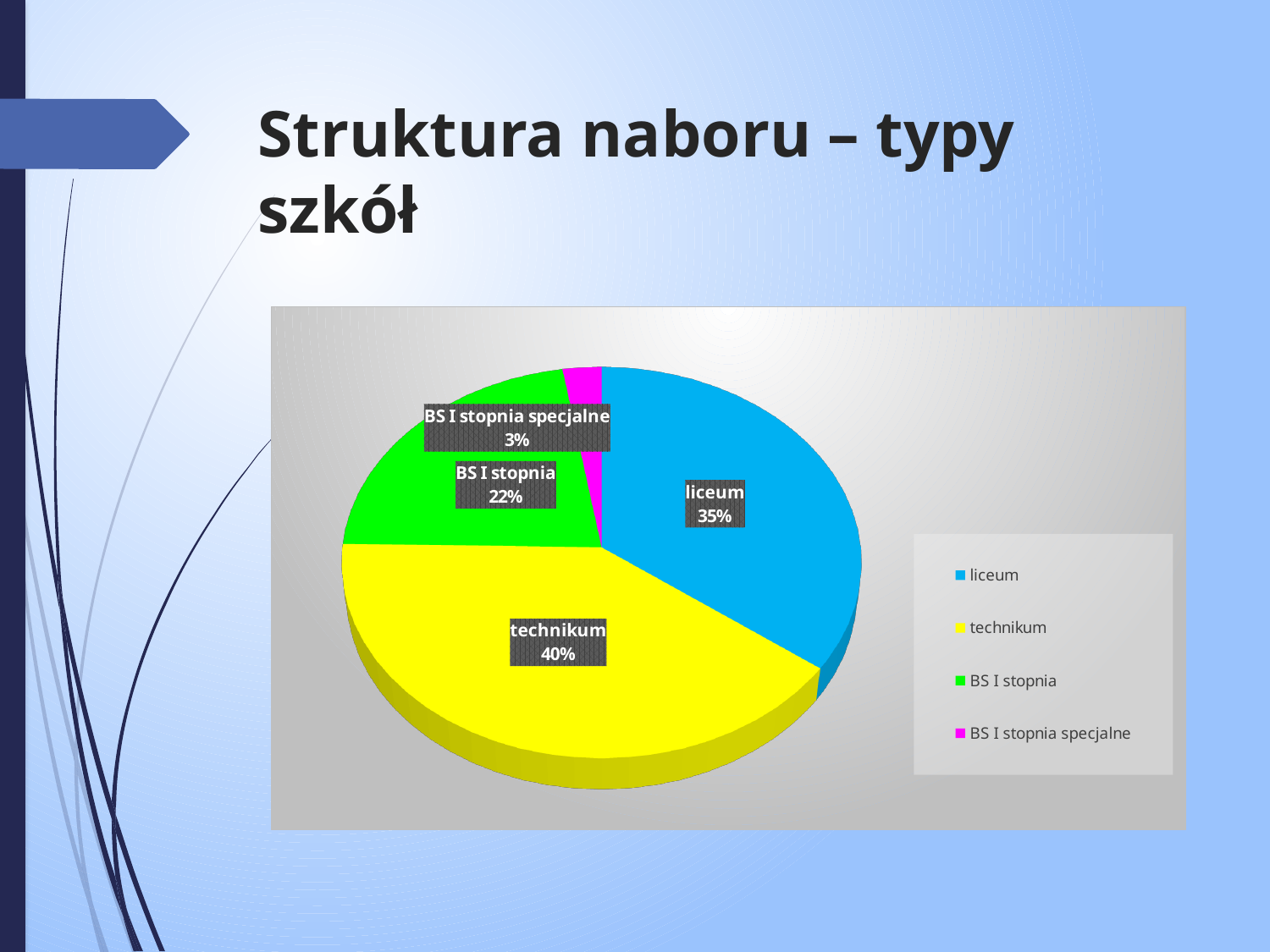
What share of the pie does liceum have? 35% What is the difference in percentage points between BS I stopnia and BS I stopnia specjalne? 19 What share of the pie does BS I stopnia specjalne have? 3% What kind of chart is shown on the slide? pie chart What colour is the technikum slice? yellow Which category has the smallest slice of the pie? BS I stopnia specjalne Which category has the largest slice of the pie? technikum What share of the pie does BS I stopnia have? 22% How many categories does the pie chart have? 4 What is the difference in percentage points between technikum and liceum? 5 Which is larger, the share for liceum or the share for BS I stopnia? liceum